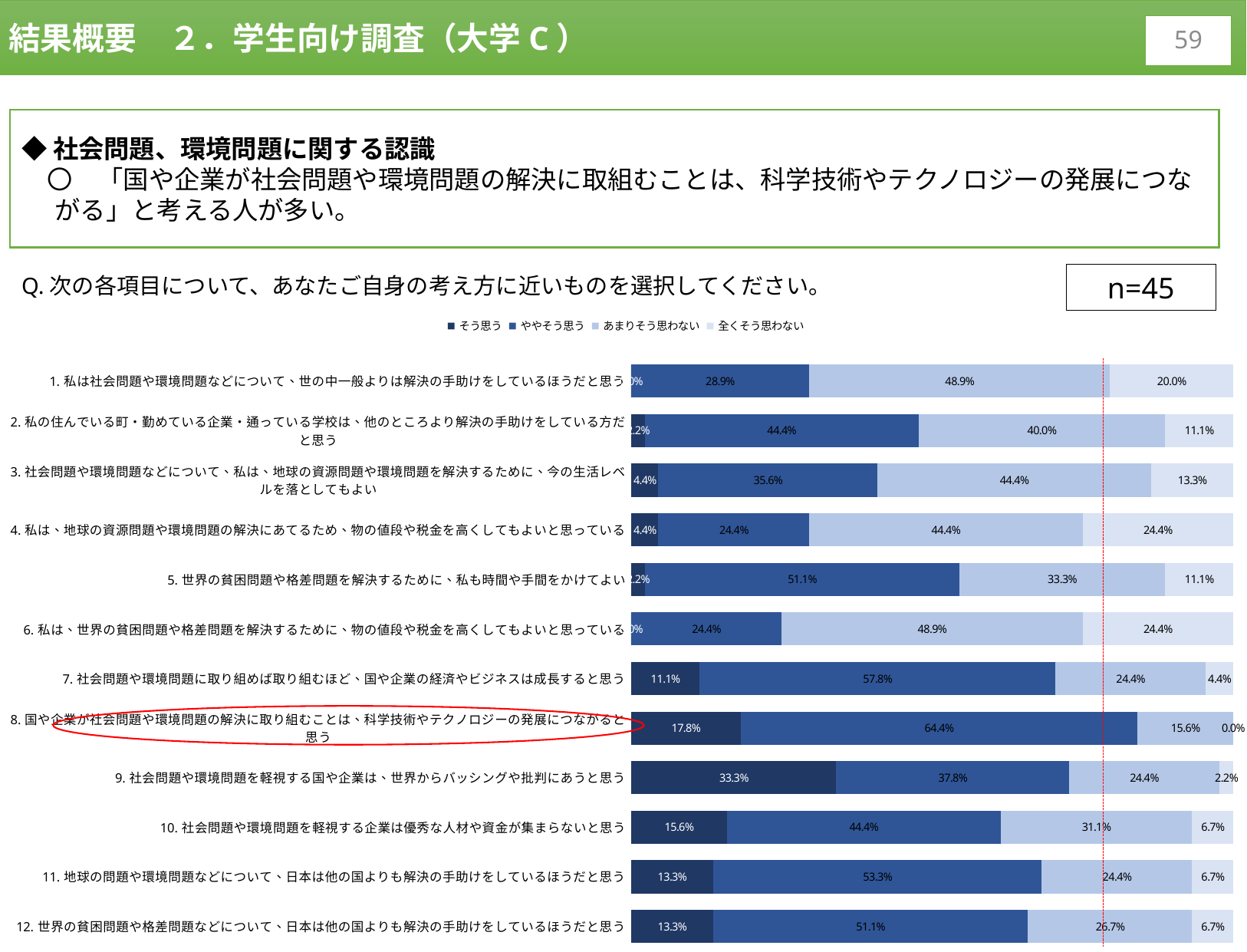
How many survey items (bars) are shown in the chart? 12 What percentage of respondents answered ややそう思う for item 8 (国や企業が社会問題や環境問題の解決に取り組むことは、科学技術やテクノロジーの発展につながると思う)? 64.4% Which is larger: the そう思う percentage for item 10 or for item 11? Item 10 (15.6%) What percentage answered あまりそう思わない for item 1 (私は社会問題や環境問題などについて、世の中一般よりは解決の手助けをしているほうだと思う)? 48.9% Which item has the highest percentage for ややそう思う? Item 8 (64.4%) Which item has the lowest percentage for 全くそう思わない? Item 8 (0.0%) What is the combined percentage of そう思う and ややそう思う for item 8? 82.2% What percentage answered そう思う for item 9 (社会問題や環境問題を軽視する国や企業は、世界からバッシングや批判にあうと思う)? 33.3% How many response categories does the legend list? 4 What percentage answered 全くそう思わない for item 4 (私は、地球の資源問題や環境問題の解決にあてるため、物の値段や税金を高くしてもよいと思っている)? 24.4% What is the difference between the ややそう思う percentages for item 8 (64.4%) and item 7 (57.8%)? 6.6 percentage points Which item has the highest percentage for そう思う? Item 9 (33.3%)